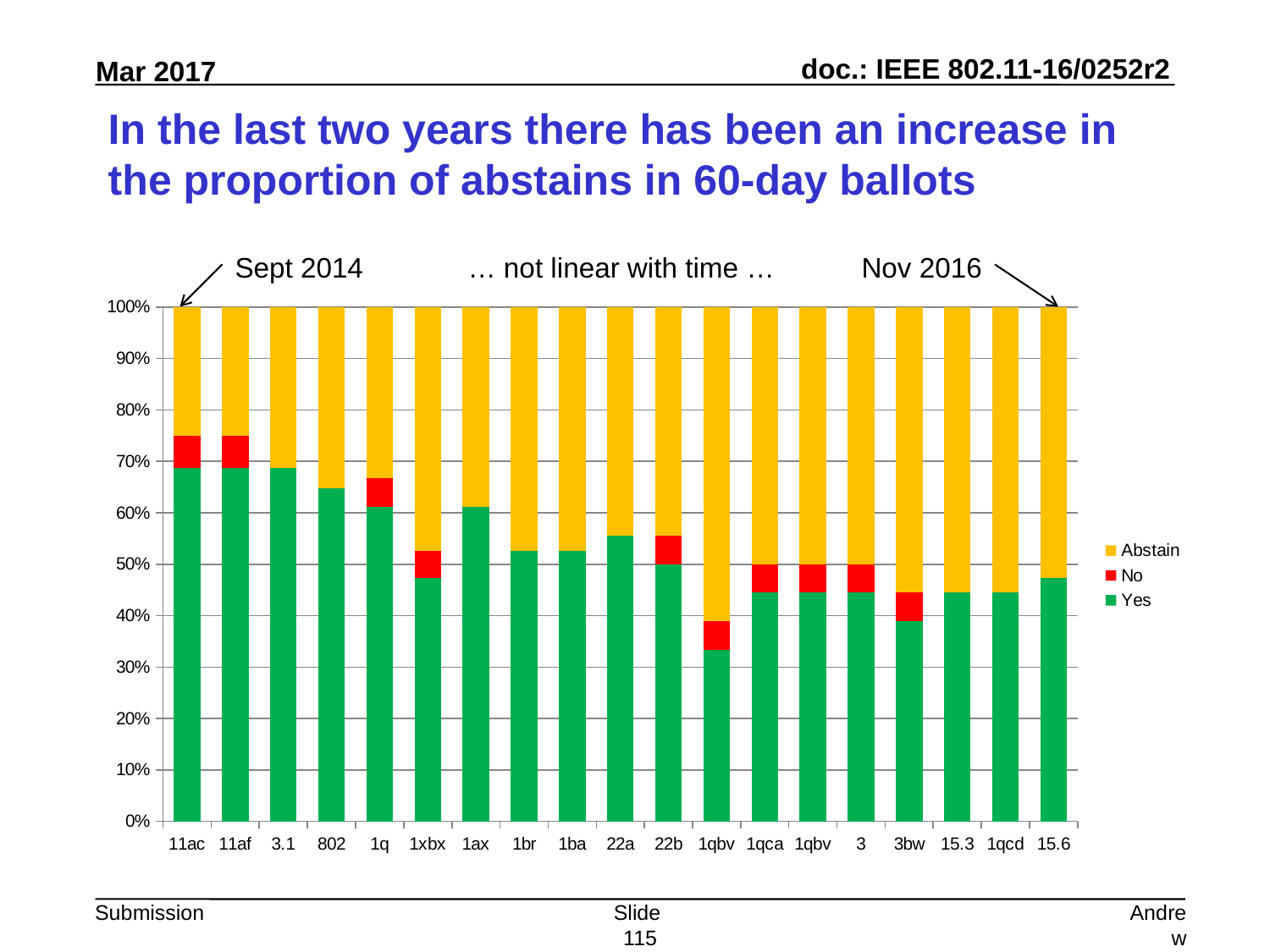
Which category has the lowest Yes proportion? 1qbv How many categories are shown along the x axis of the chart? 19 Which has the larger Yes proportion, 802 or 15.6? 802 What is the total of the stacked bar for 11ac? 100% Is the Yes value for 15.6 greater or less than 50%? less Which series are listed in the chart's legend? Abstain, No, Yes Does the Yes proportion generally rise or fall moving from left to right along the x axis? fall What kind of chart is shown on the slide? stacked bar chart How many series does the chart's legend list? 3 Is the Yes value for 1ax greater or less than 50%? greater Is the Yes value for 11ac greater or less than 60%? greater